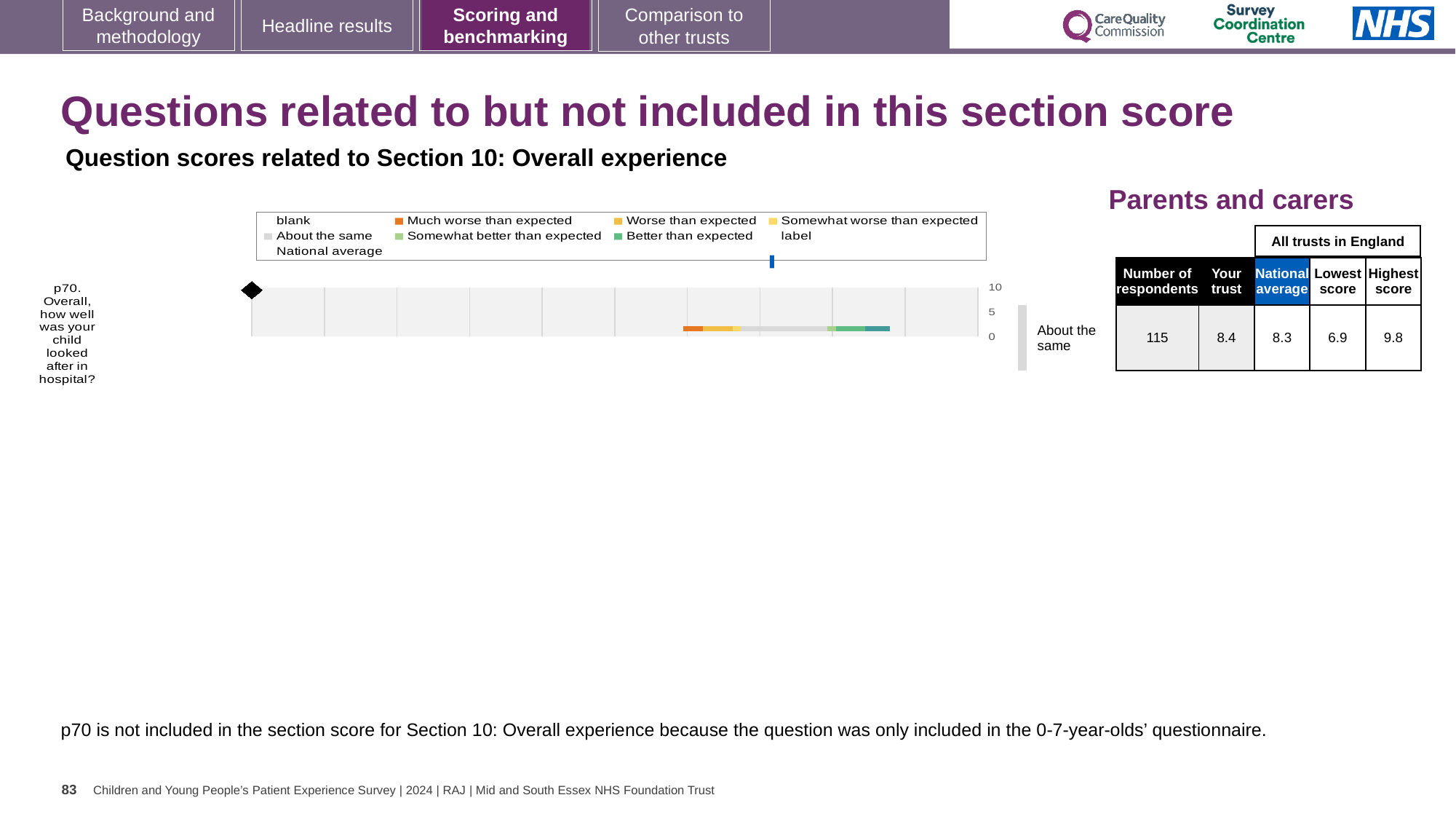
What is the national average score for p70? 8.3 What is the highest score among all trusts in England for p70? 9.8 What kind of chart is used to show the p70 question score? bar chart What is the difference between the highest and lowest trust scores for p70? 2.9 What is the 'Your trust' score for p70 (Overall, how well was your child looked after in hospital?)? 8.4 How many respondents answered p70? 115 What is the lowest score among all trusts in England for p70? 6.9 How many questions are plotted in the chart? 1 Is the 'Your trust' score for p70 greater or less than 5? greater What benchmark category label is shown next to the p70 bar? About the same By how much does the 'Your trust' score for p70 exceed the national average? 0.1 Which is higher for p70: the 'Your trust' score or the national average? Your trust